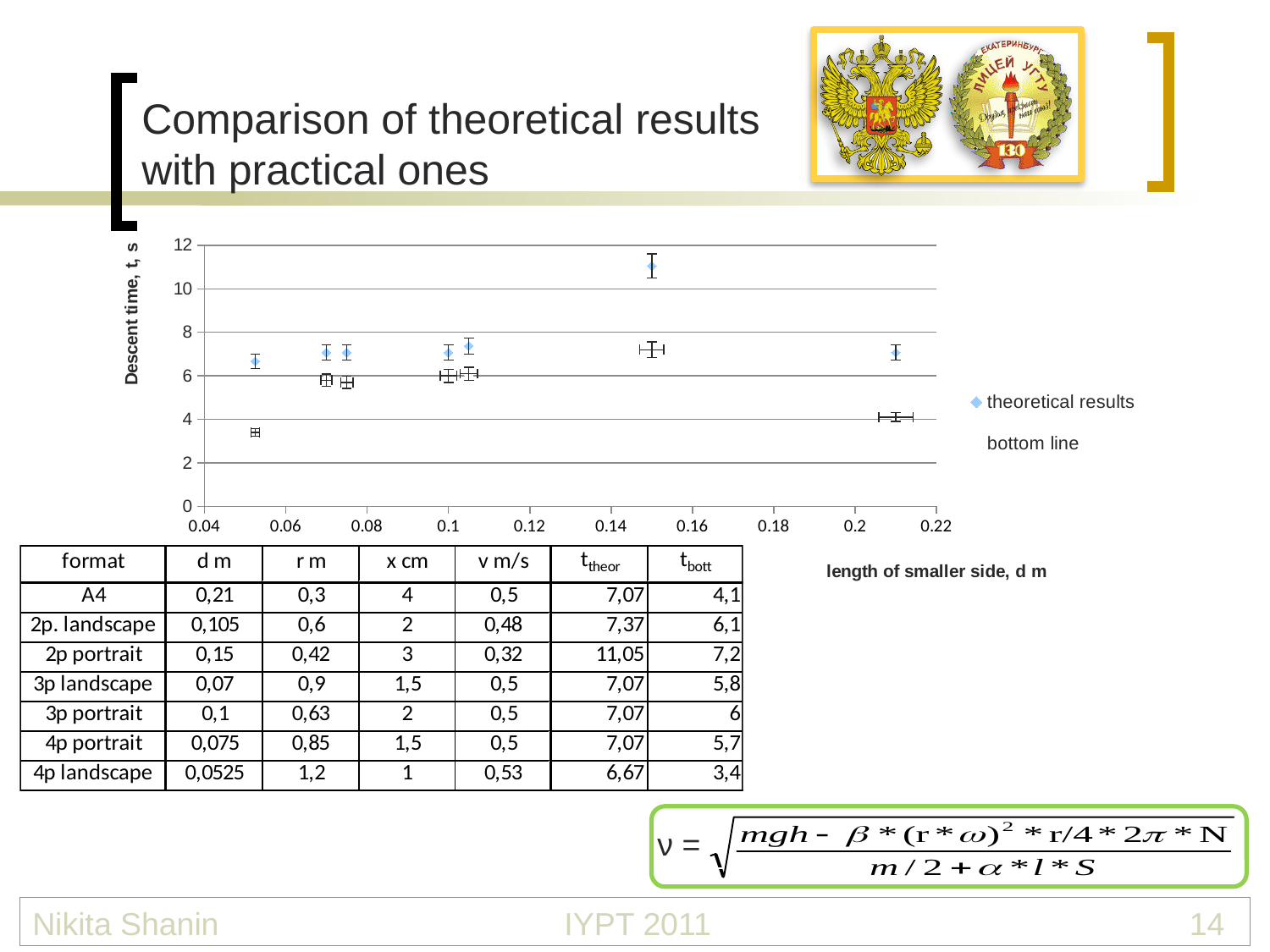
How many series does the chart legend list? 2 What is the title of the vertical axis of the chart? Descent time, t, s Is the theoretical results value at d = 0.15 greater or less than 10? greater At which x value (length of smaller side) is the theoretical results point highest? 0.15 What are the two series named in the chart legend? theoretical results, bottom line At which x value is the bottom line point lowest? 0.0525 Is the bottom line value at d = 0.0525 greater or less than 4? less What kind of chart is shown on the slide? scatter chart At d = 0.15, which series has the larger descent time, theoretical results or bottom line? theoretical results Is the bottom line value at d = 0.21 greater or less than 6? less At d = 0.21, which series has the larger descent time, theoretical results or bottom line? theoretical results How many data points does the theoretical results series have? 7